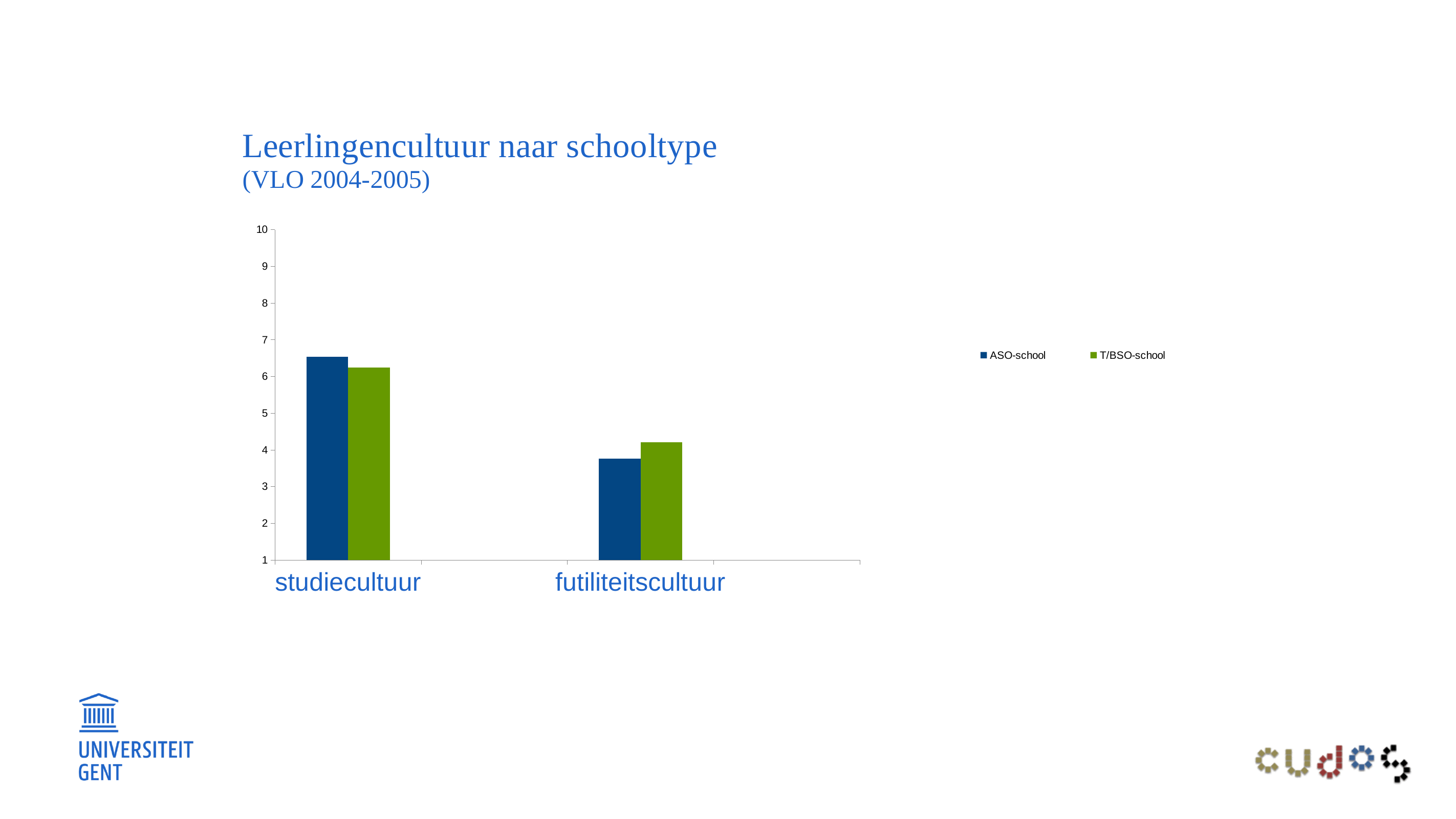
Which bar in the chart is the highest overall? ASO-school for studiecultuur Is the ASO-school value for futiliteitscultuur greater or less than 4? less For futiliteitscultuur, which series has the higher value, ASO-school or T/BSO-school? T/BSO-school How many categories are shown on the x axis of the chart? 2 For studiecultuur, which series has the higher value, ASO-school or T/BSO-school? ASO-school Is the ASO-school value for studiecultuur greater or less than 6? greater Which bar in the chart is the lowest overall? ASO-school for futiliteitscultuur What is the title of the chart on the slide? Leerlingencultuur naar schooltype (VLO 2004-2005) What kind of chart is shown on the slide? bar chart What are the two series listed in the chart's legend? ASO-school and T/BSO-school How many series does the chart's legend list? 2 Is the T/BSO-school value for futiliteitscultuur greater or less than 5? less